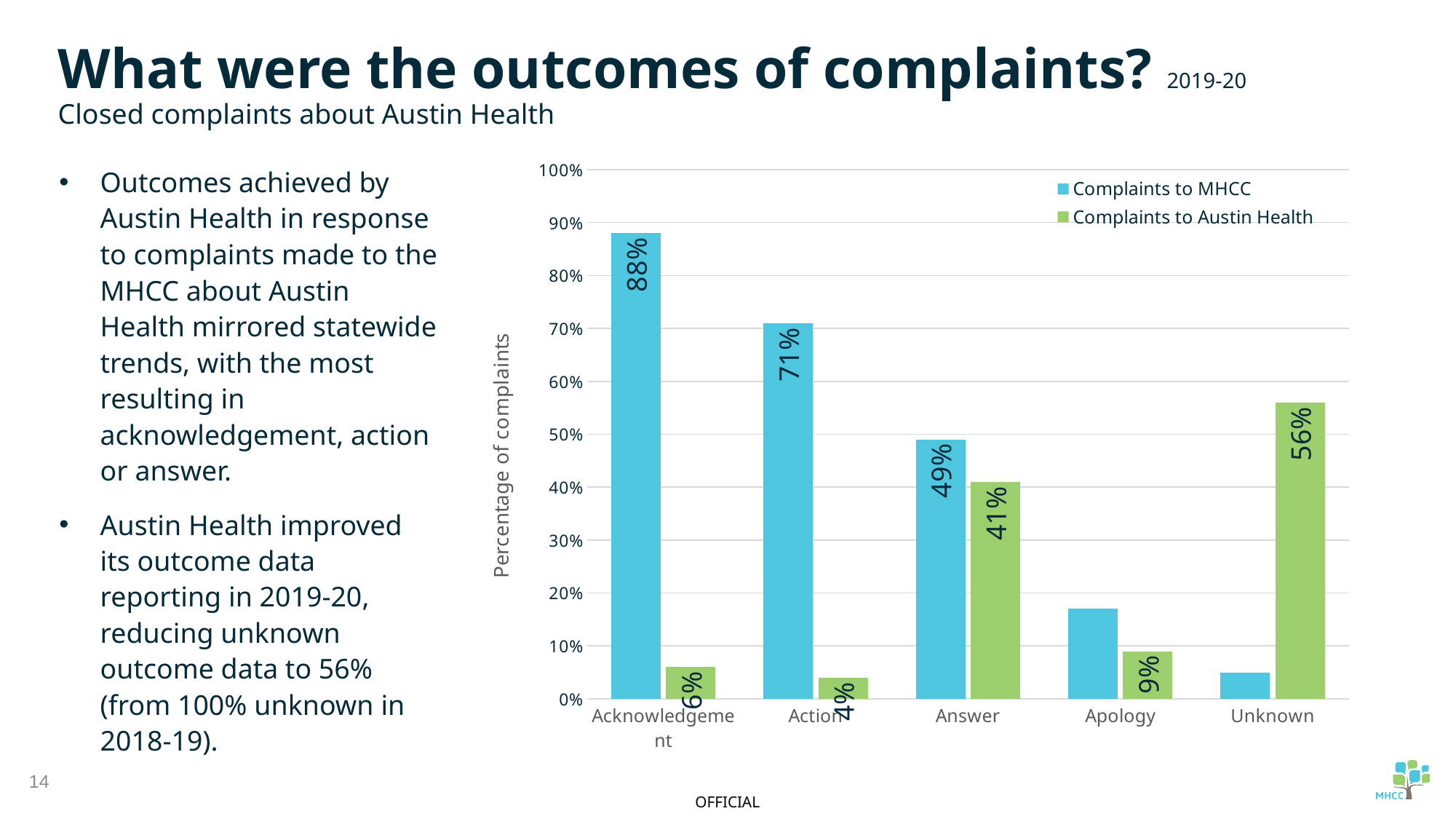
Which category has the highest value for Complaints to Austin Health? Unknown In the Acknowledgement category, which series has the larger value, Complaints to MHCC or Complaints to Austin Health? Complaints to MHCC What is the value for Complaints to Austin Health in the Answer category? 41% How many series does the chart's legend list? 2 Which category has the lowest value for Complaints to Austin Health? Action How many categories are shown on the x axis of the chart? 5 In the Answer category, what is the difference between Complaints to MHCC and Complaints to Austin Health? 8 percentage points Which category has the highest value for Complaints to MHCC? Acknowledgement Is the value for Complaints to MHCC in the Unknown category greater or less than 10%? less What is the value for Complaints to MHCC in the Acknowledgement category? 88% Is the value for Complaints to MHCC in the Apology category greater or less than 20%? less What is the value for Complaints to Austin Health in the Unknown category? 56%